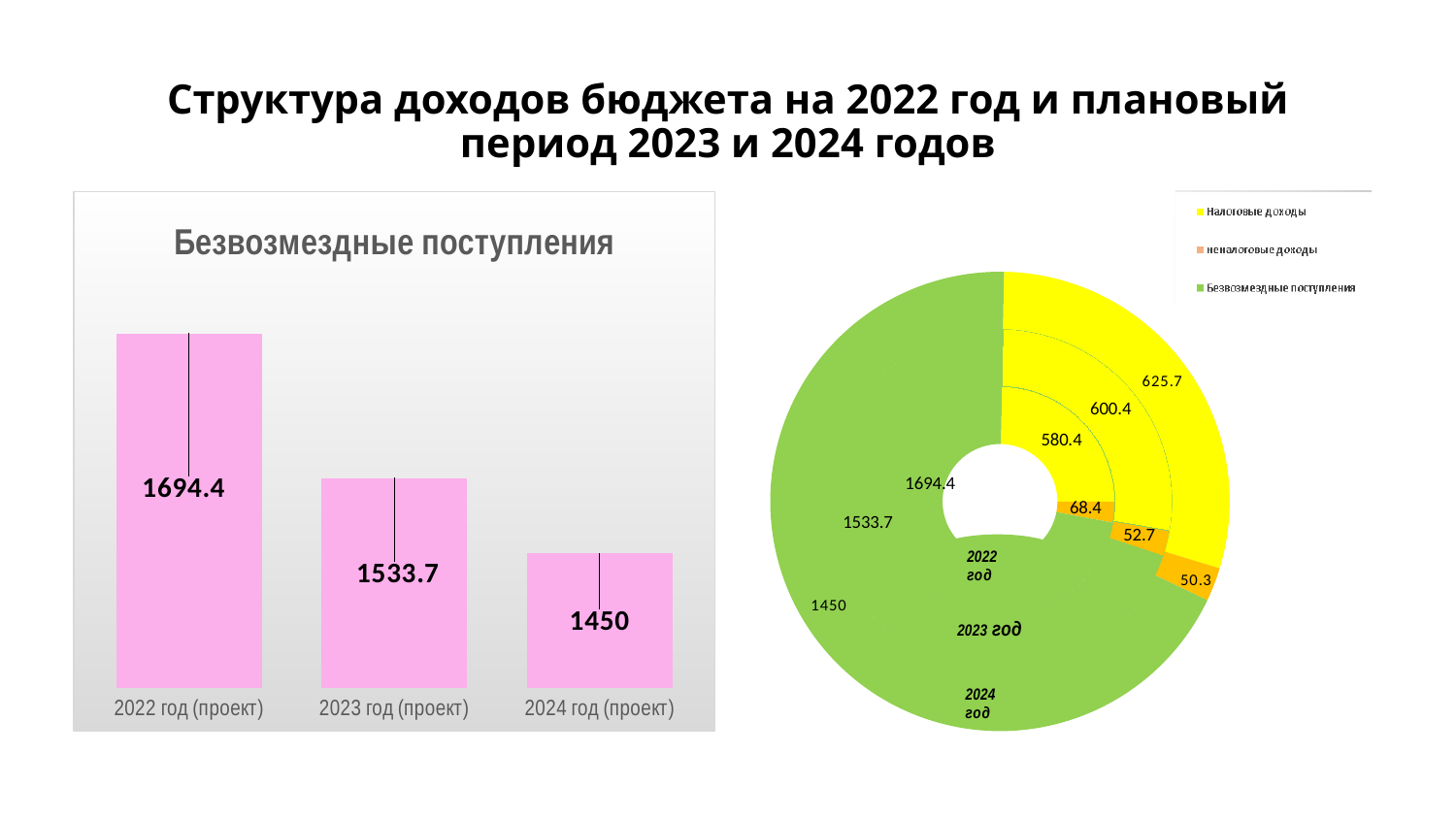
On the bar chart 'Безвозмездные поступления', what is the difference between the 2022 and 2023 values? 160.7 On the bar chart 'Безвозмездные поступления', do the values rise or fall from 2022 to 2024? fall On the doughnut chart on the right, what is the value of неналоговые доходы for 2022 год (inner ring)? 68.4 On the bar chart 'Безвозмездные поступления', what is the value for 2022 год (проект)? 1694.4 On the bar chart 'Безвозмездные поступления', which year has the lowest value? 2024 год (проект) On the bar chart 'Безвозмездные поступления', how many bars are shown? 3 On the bar chart 'Безвозмездные поступления', which year has the highest value? 2022 год (проект) On the bar chart 'Безвозмездные поступления', what is the value for 2024 год (проект)? 1450 What kind of chart is the chart on the left of the slide? bar chart On the doughnut chart on the right, which is larger: Налоговые доходы for 2022 год (580.4) or for 2023 год (600.4)? 2023 год On the doughnut chart on the right, how many series does the legend list? 3 On the doughnut chart on the right, what is the value of Налоговые доходы for 2024 год (outer ring)? 625.7